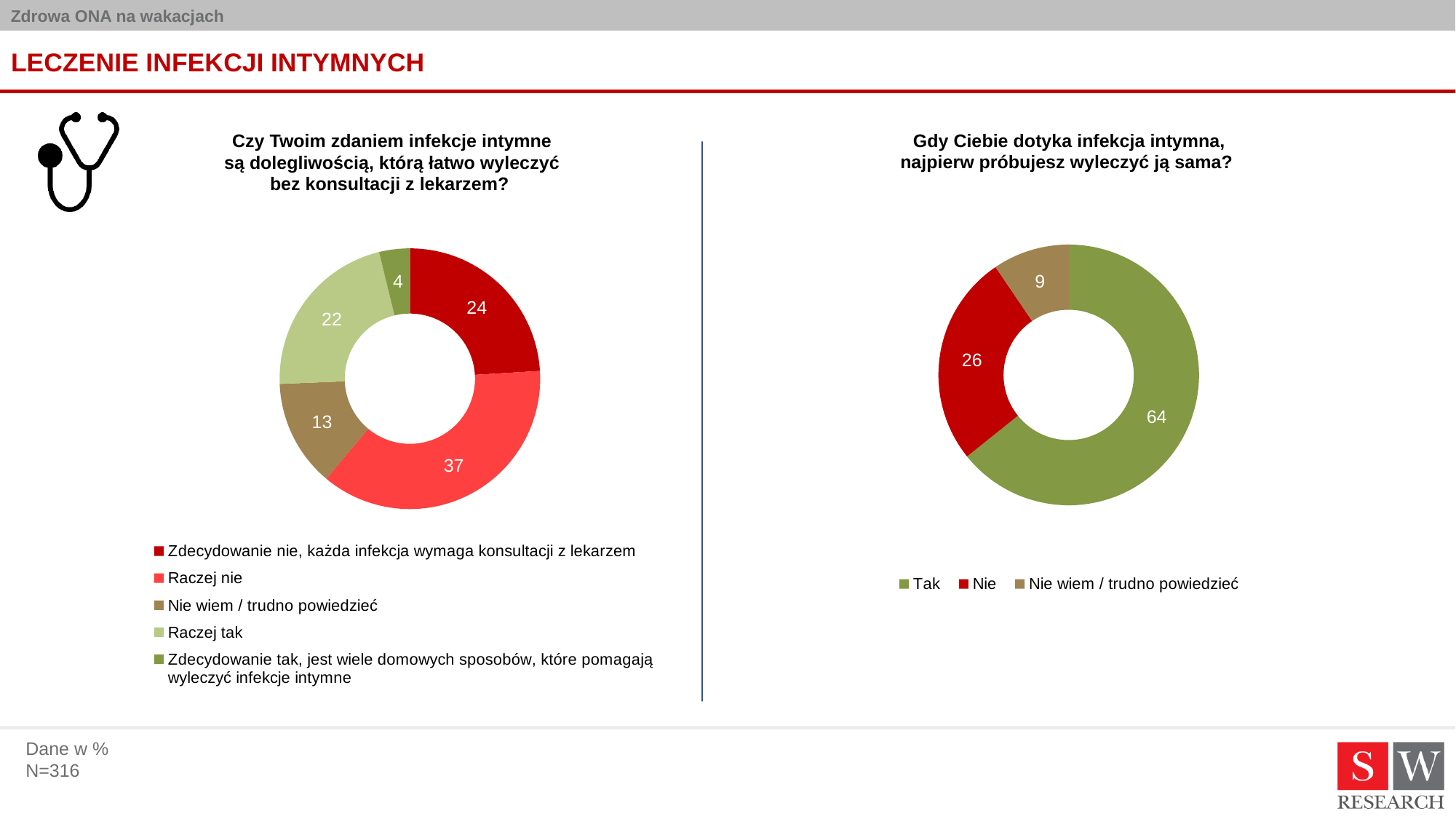
In the left chart, which category has the smallest value? Zdecydowanie tak, jest wiele domowych sposobów, które pomagają wyleczyć infekcje intymne In the left chart, what is the value for "Zdecydowanie nie, każda infekcja wymaga konsultacji z lekarzem"? 24 In the left chart, how many categories does the legend list? 5 In the right chart, what is the difference between "Tak" and "Nie"? 38 In the right chart, which is larger, "Tak" or "Nie"? Tak In the right chart, what colour is the "Nie" slice? Red In the left chart (Czy Twoim zdaniem infekcje intymne są dolegliwością, którą łatwo wyleczyć bez konsultacji z lekarzem?), what is the value for "Raczej nie"? 37 In the right chart (Gdy Ciebie dotyka infekcja intymna, najpierw próbujesz wyleczyć ją sama?), what is the value for "Tak"? 64 In the right chart, what is the value for "Nie wiem / trudno powiedzieć"? 9 In the left chart, what is the difference between "Raczej nie" and "Raczej tak"? 15 In the left chart, which category has the largest value? Raczej nie What type of chart is used on the right side of the slide? Doughnut (pie) chart